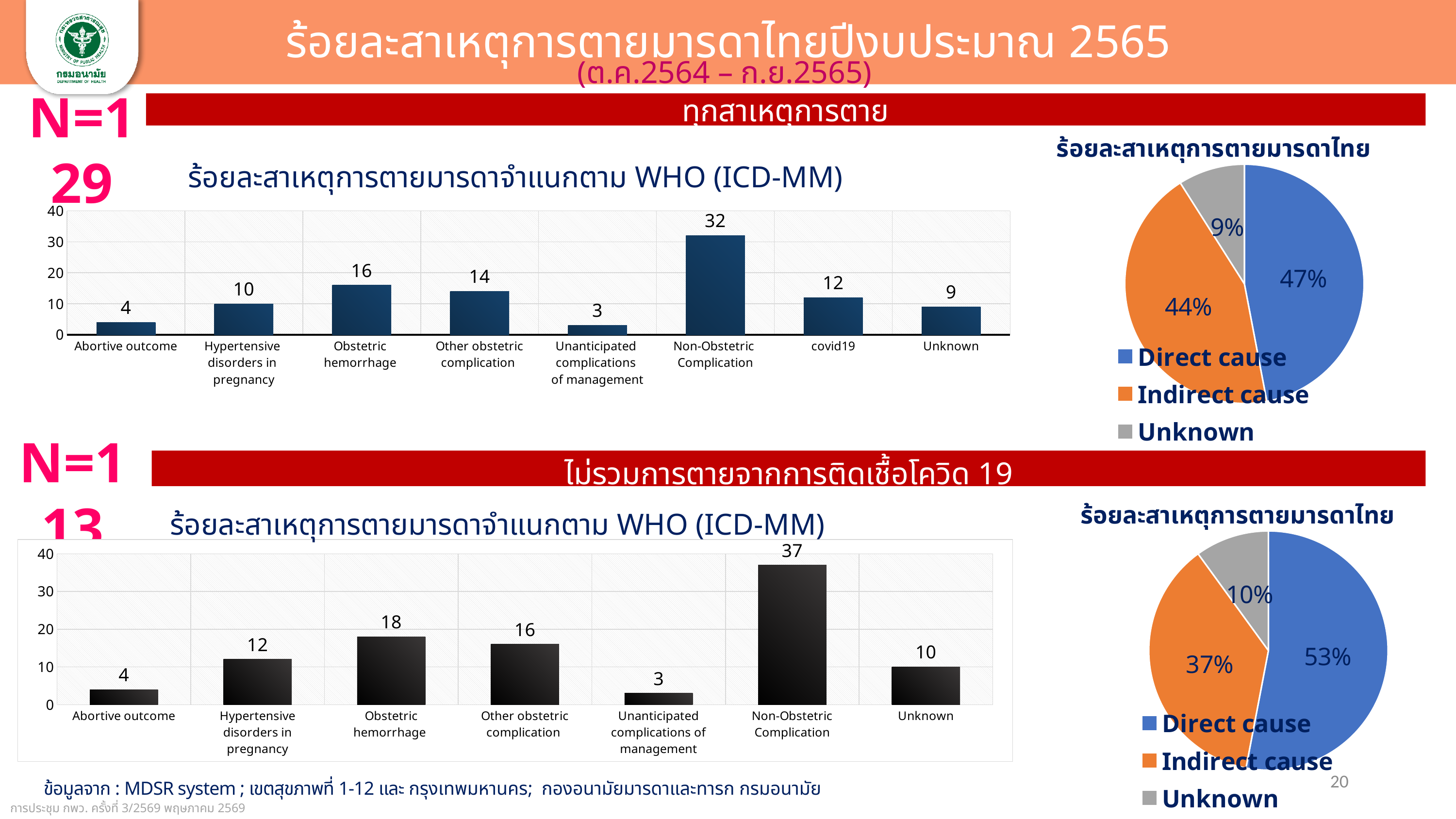
In the top bar chart, how many categories are shown on the x axis? 8 In the top bar chart, what is the difference between Obstetric hemorrhage and Other obstetric complication? 2 In the top-right pie chart, how many entries does the legend list? 3 In the bottom bar chart, how many categories are shown on the x axis? 7 In the bottom-right pie chart, what share is Direct cause? 53% In the bottom bar chart, which category has the highest value? Non-Obstetric Complication In the top bar chart, what is the value for Non-Obstetric Complication? 32 In the bottom bar chart, what is the value for Obstetric hemorrhage? 18 In the top bar chart, what is the value for covid19? 12 In the bottom bar chart, which is larger: Hypertensive disorders in pregnancy or Unknown? Hypertensive disorders in pregnancy In the top-right pie chart, what share is Indirect cause? 44% In the top bar chart, which category has the lowest value? Unanticipated complications of management